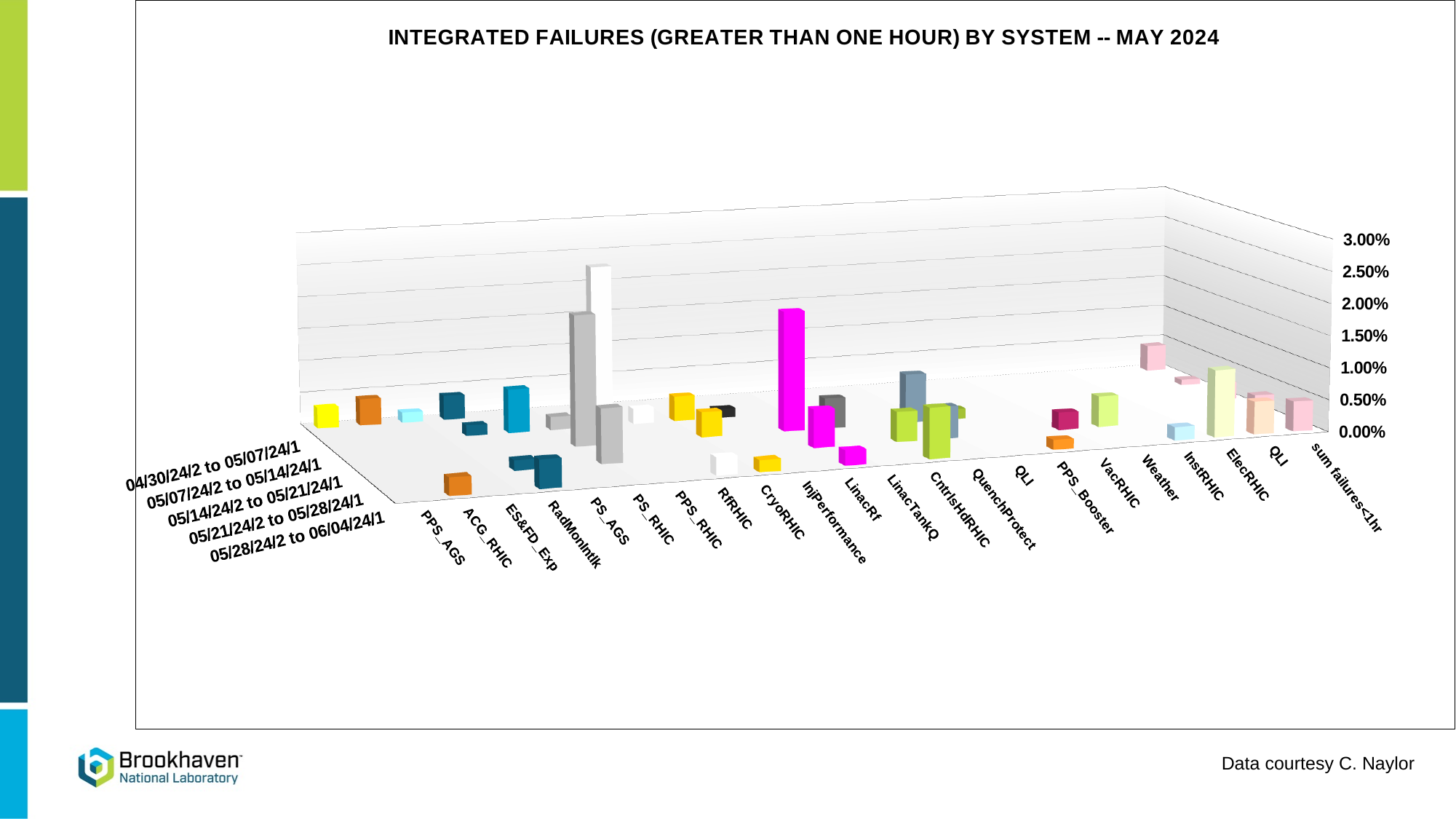
What kind of chart is shown on the slide? bar chart Is the value of the tallest magenta bar in the chart greater or less than 1.00%? greater What is the highest value shown on the vertical axis of the chart? 3.00% How many weekly time periods are listed along the depth axis of the chart? 5 What is the last time period listed on the depth axis of the chart? 05/28/24/2 to 06/04/24/1 What is the last category label on the x axis of the chart? sum failures<1hr What is the title of the chart? INTEGRATED FAILURES (GREATER THAN ONE HOUR) BY SYSTEM -- MAY 2024 Is the value of the tallest bar in the chart greater or less than 1.00%? greater How many system categories are labelled along the x axis of the chart? 22 Is the value of the yellow bar for PPS_AGS in the first time period greater or less than 1.00%? less What is the first time period listed on the depth axis of the chart? 04/30/24/2 to 05/07/24/1